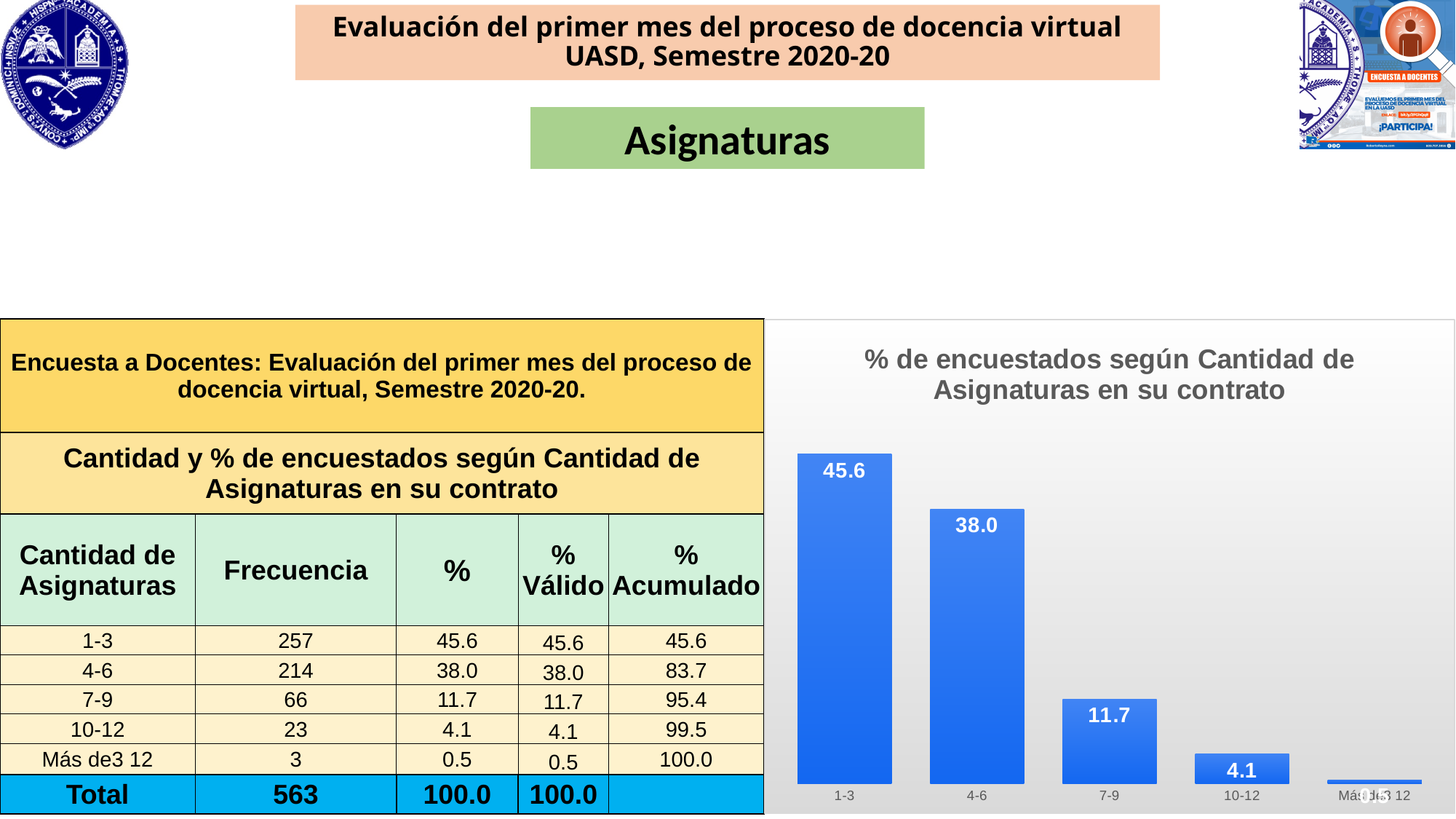
What is the difference between the values for 1-3 and 4-6 in the chart? 7.6 Do the values in the chart rise or fall from left to right along the x axis? fall Which category has the highest value in the chart? 1-3 What type of chart is shown on the slide? bar chart How many categories are shown in the chart? 5 What is the value for the 1-3 category in the chart? 45.6 Which category has the lowest value in the chart? Más de3 12 What is the value for the 10-12 category in the chart? 4.1 What is the value for the 7-9 category in the chart? 11.7 Which is larger in the chart, the value for 7-9 or the value for 10-12? 7-9 What is the title of the chart on the slide? % de encuestados según Cantidad de Asignaturas en su contrato What is the value for the 4-6 category in the chart? 38.0